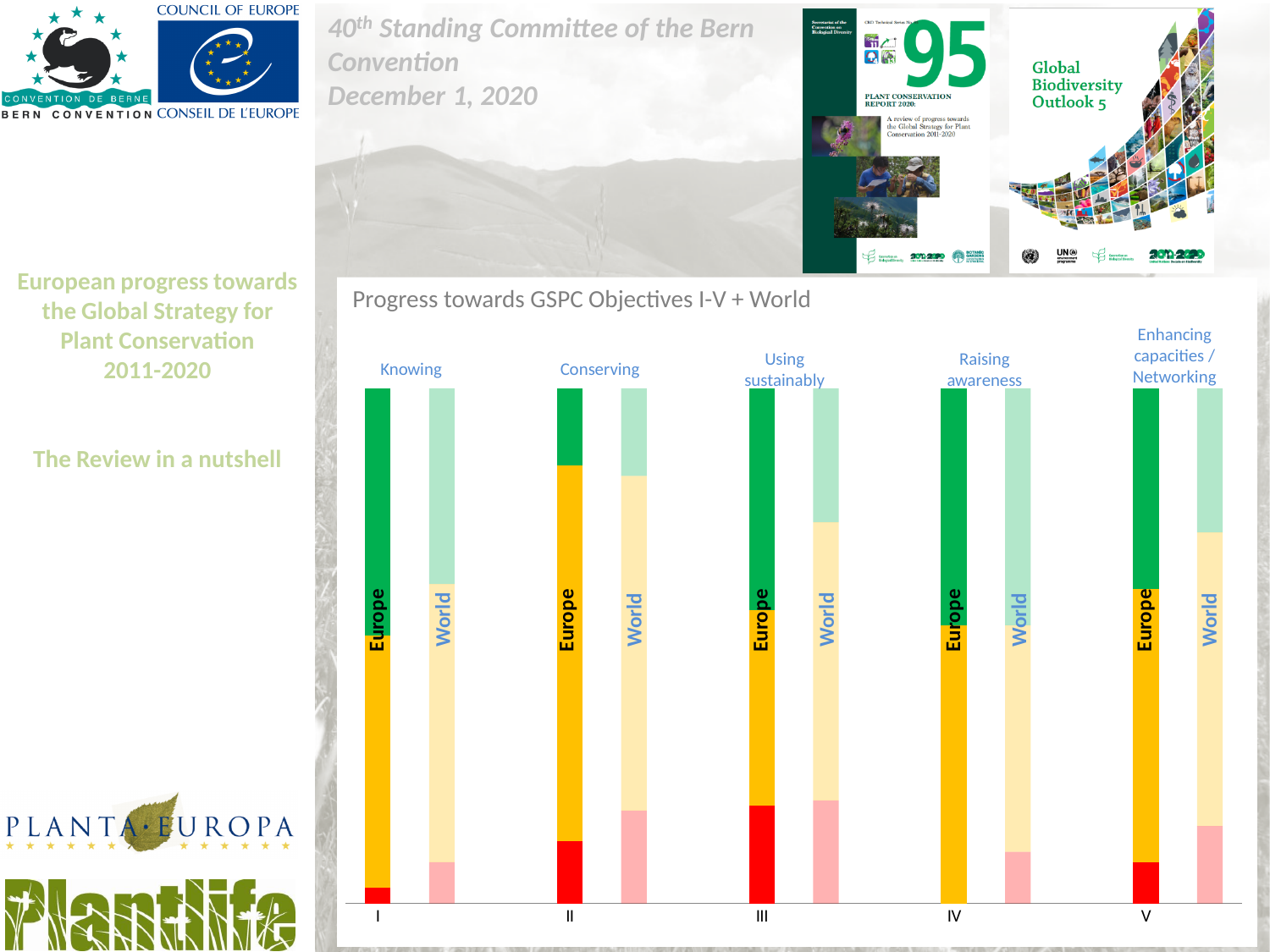
Which two groups are compared for each objective in the chart? Europe and World For Objective V, is the green segment larger for Europe or for World? Europe For which objective is the green segment of the Europe bar the smallest? II What is the title of the chart? Progress towards GSPC Objectives I-V + World Which objective's Europe bar has no red segment at all? IV For Objective III, is the green segment larger for Europe or for World? Europe For which objective is the red segment of the Europe bar the largest? III What kind of chart is shown on the slide? Stacked bar chart For which objective is the green segment of the World bar the largest? IV How many GSPC objectives are shown along the x axis of the chart? 5 What is the label given to Objective III in the chart? Using sustainably How many bars are plotted in the chart in total? 10